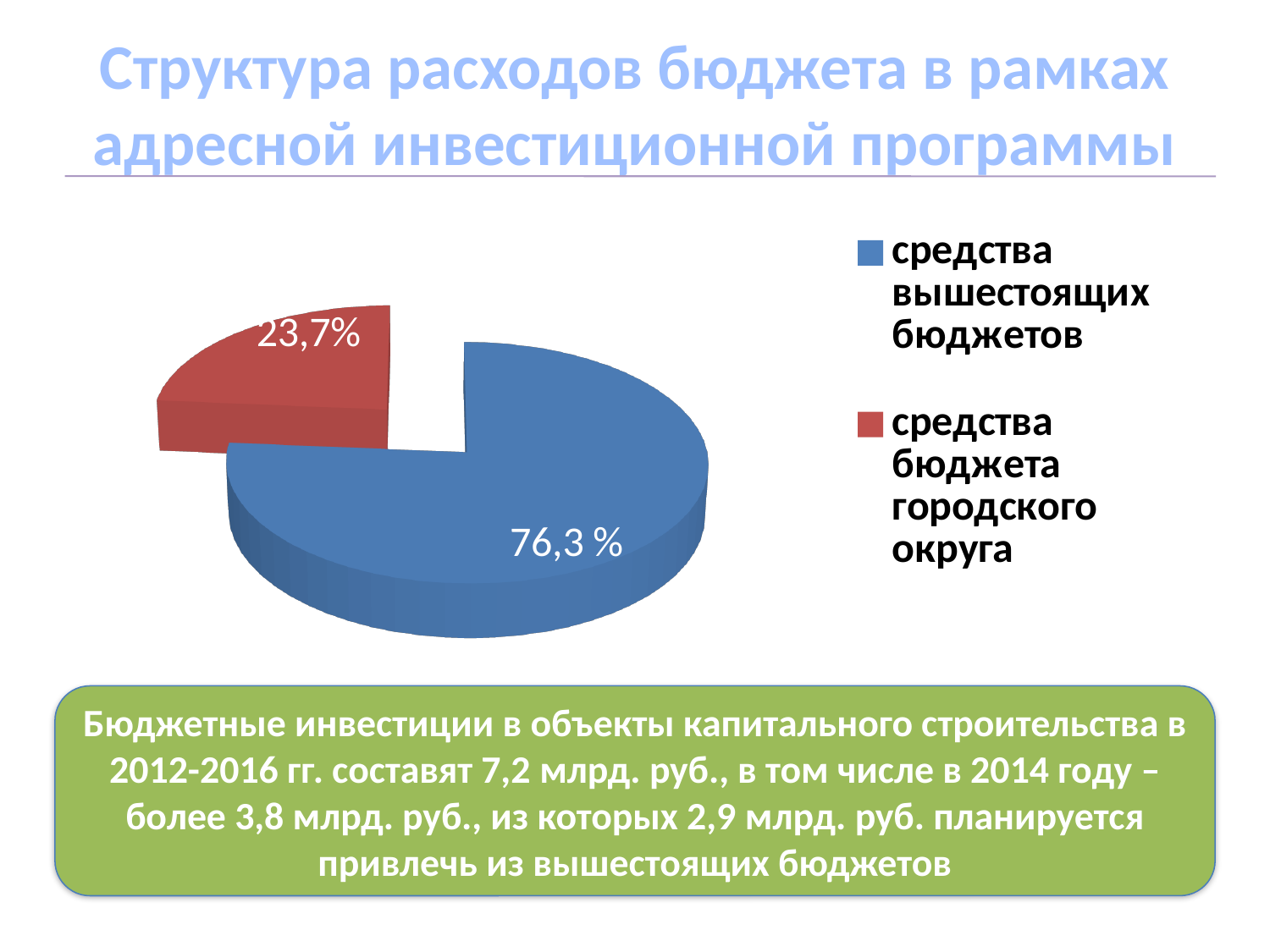
How many slices does the pie chart have? 2 Which category has the smallest slice of the pie? средства бюджета городского округа What colour is the slice for средства вышестоящих бюджетов? blue Which category has the largest slice of the pie? средства вышестоящих бюджетов What share of the pie does the slice for средства бюджета городского округа represent? 23,7% What share of the pie does the slice for средства вышестоящих бюджетов represent? 76,3 % What kind of chart is shown on the slide? pie chart By how many percentage points does the slice for средства вышестоящих бюджетов exceed the slice for средства бюджета городского округа? 52,6 What is the title of the slide containing the chart? Структура расходов бюджета в рамках адресной инвестиционной программы How many entries does the legend list? 2 What is the share of the red slice in the pie? 23,7% Which is larger: the slice for средства вышестоящих бюджетов or the slice for средства бюджета городского округа? средства вышестоящих бюджетов